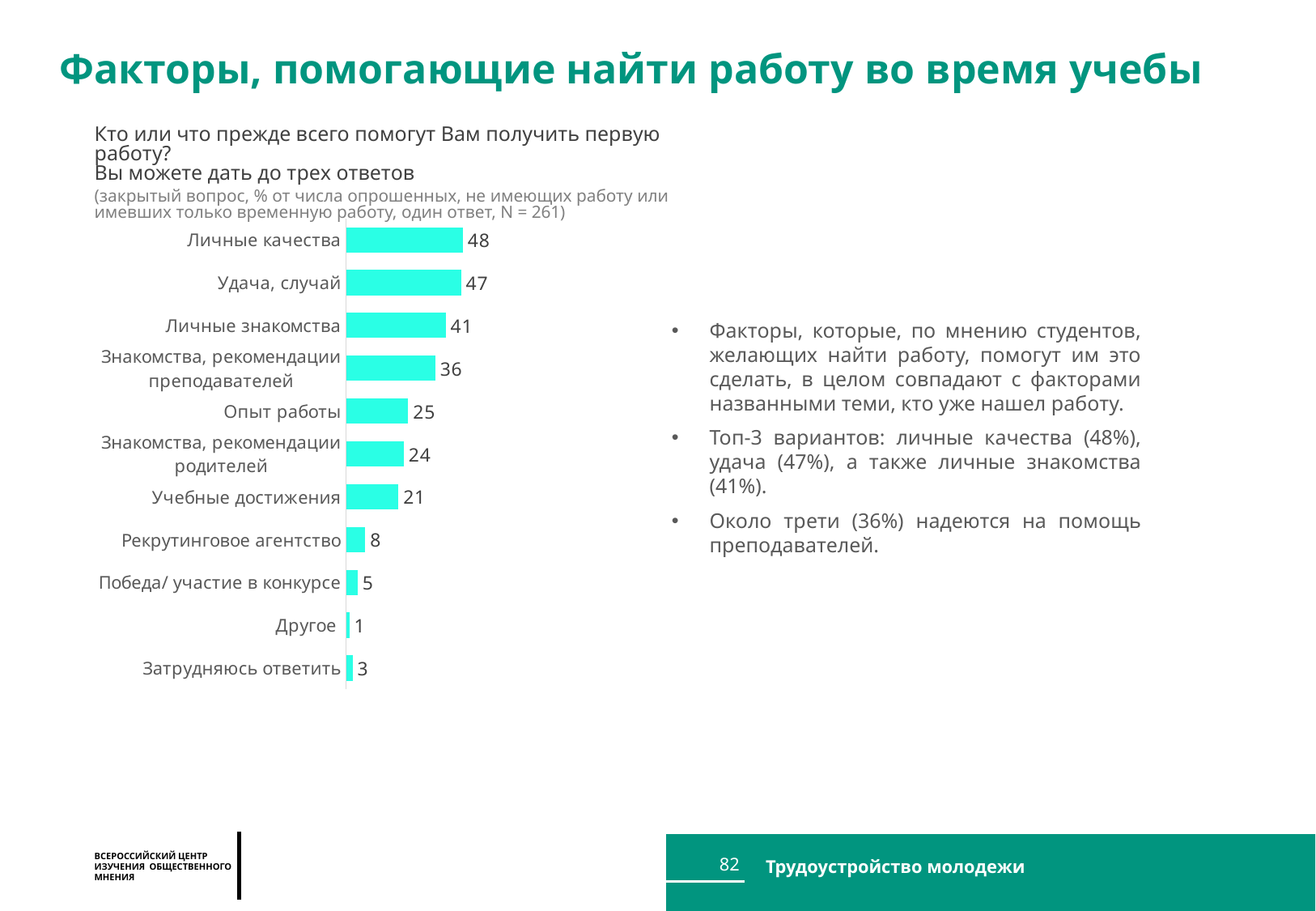
What kind of chart is shown on the slide? Bar chart How many categories are shown in the chart? 11 What value is shown for «Рекрутинговое агентство»? 8 What is the difference between the values for «Личные знакомства» and «Учебные достижения»? 20 What value is shown for «Личные качества»? 48 Which category has the lowest value? Другое Which is larger: the value for «Опыт работы» or for «Знакомства, рекомендации родителей»? Опыт работы What colour are the bars in the chart? Turquoise What value is shown for «Знакомства, рекомендации преподавателей»? 36 What value is shown for «Опыт работы»? 25 Which category has the highest value? Личные качества What is the difference between the values for «Удача, случай» and «Победа/ участие в конкурсе»? 42